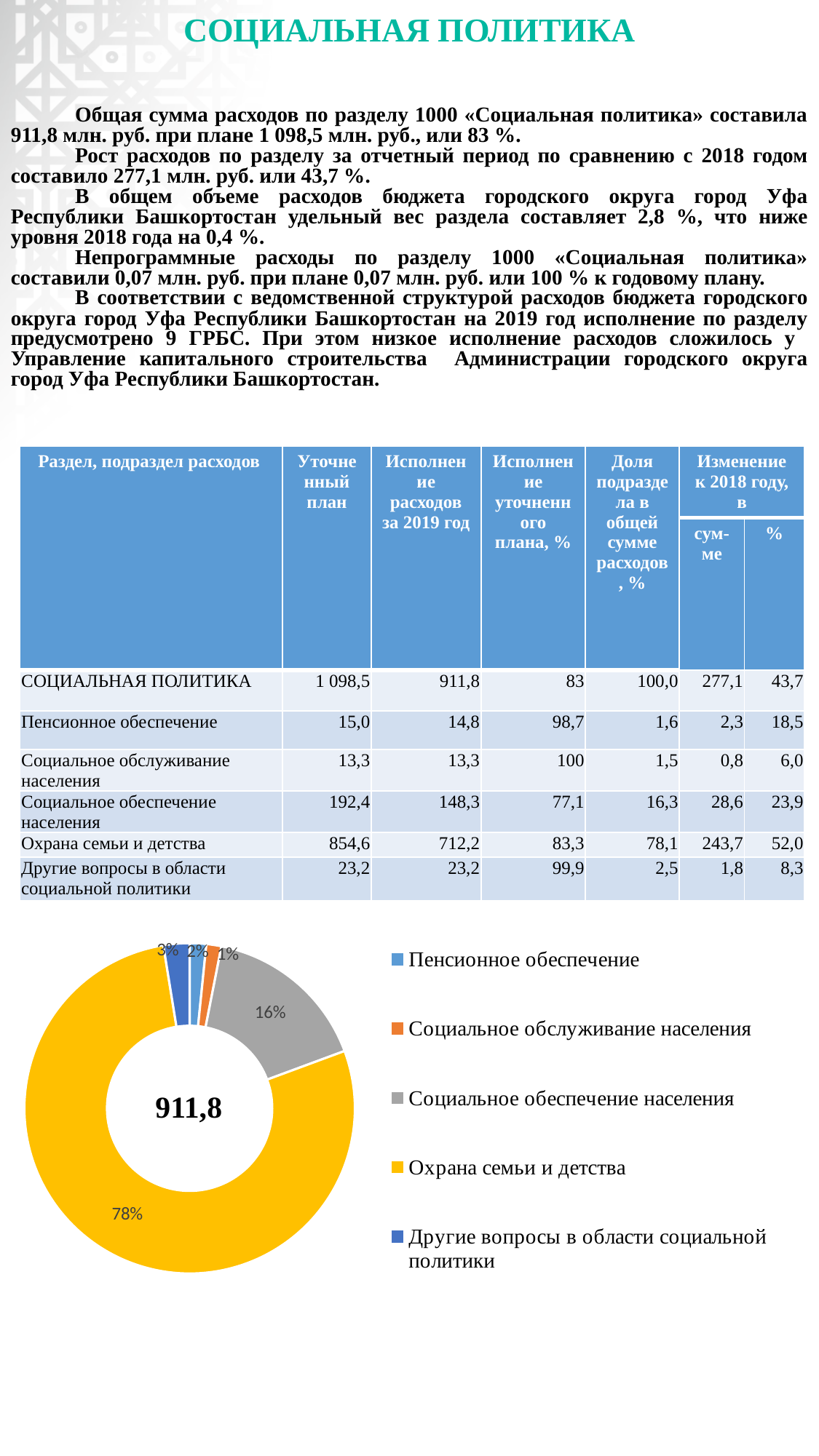
What share of the doughnut chart does "Другие вопросы в области социальной политики" take? 3% What share of the doughnut chart does "Пенсионное обеспечение" take? 2% What share of the doughnut chart does "Социальное обеспечение населения" take? 16% How many categories does the doughnut chart's legend list? 5 What number is printed in the centre of the doughnut chart? 911,8 Which category has the smallest slice in the doughnut chart? Социальное обслуживание населения Which slice is larger in the doughnut chart: "Социальное обеспечение населения" or "Пенсионное обеспечение"? Социальное обеспечение населения What kind of chart is shown on the slide? doughnut (pie) chart Which category has the largest slice in the doughnut chart? Охрана семьи и детства What colour is the "Охрана семьи и детства" slice in the doughnut chart? yellow